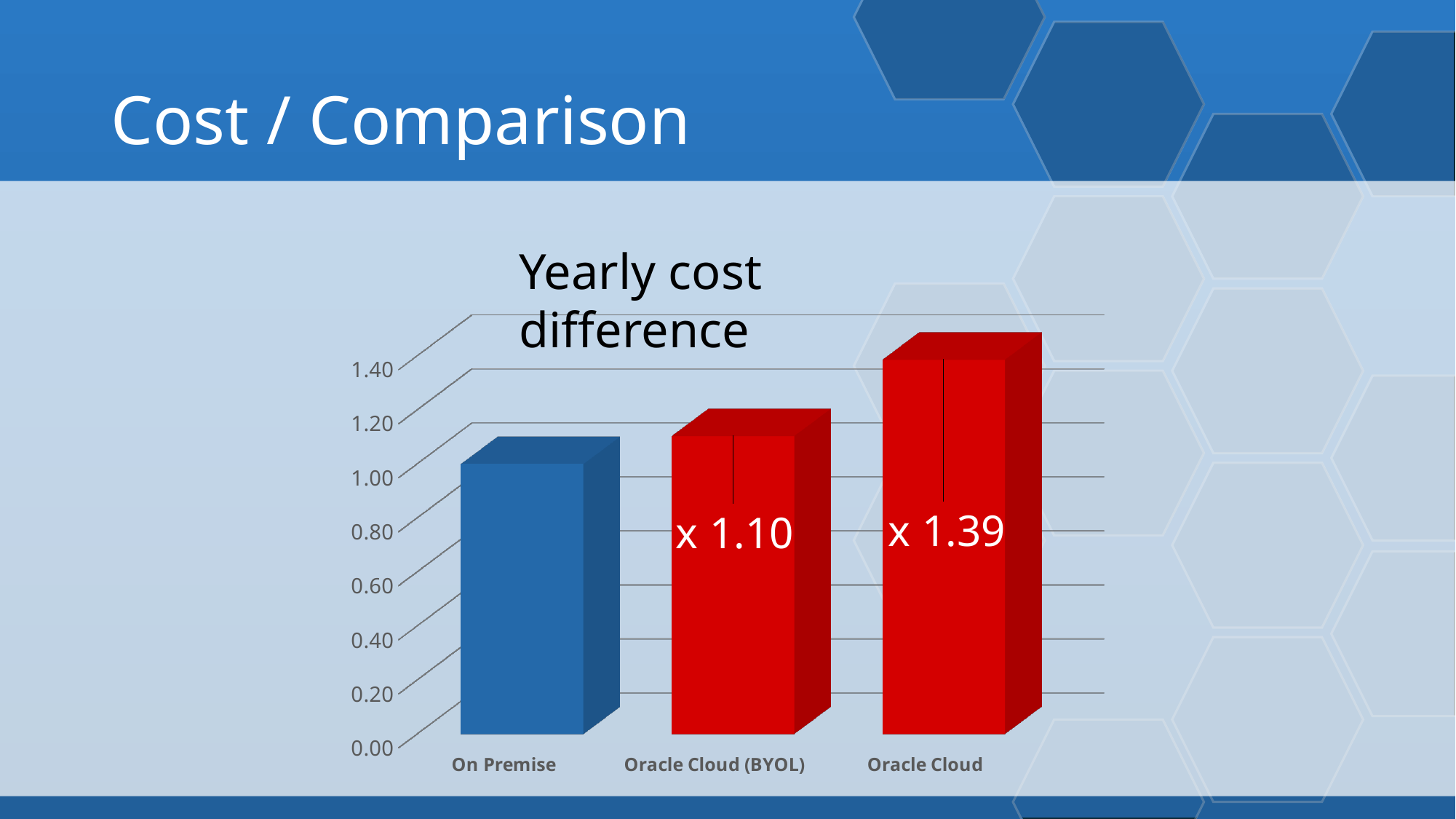
Which category has the lowest bar? On Premise Which is larger, the value for Oracle Cloud (BYOL) or the value for On Premise? Oracle Cloud (BYOL) How many categories are shown on the x axis of the chart? 3 What multiplier is printed on the Oracle Cloud bar? x 1.39 What kind of chart is shown on the slide? bar chart Which category has the highest bar? Oracle Cloud Do the bar values rise or fall from left to right along the x axis? rise What multiplier is printed on the Oracle Cloud (BYOL) bar? x 1.10 Is the value for On Premise greater or less than 0.80? greater What colour is the On Premise bar? blue What is the difference between the multipliers printed for Oracle Cloud and Oracle Cloud (BYOL)? 0.29 What is the title of the chart? Yearly cost difference